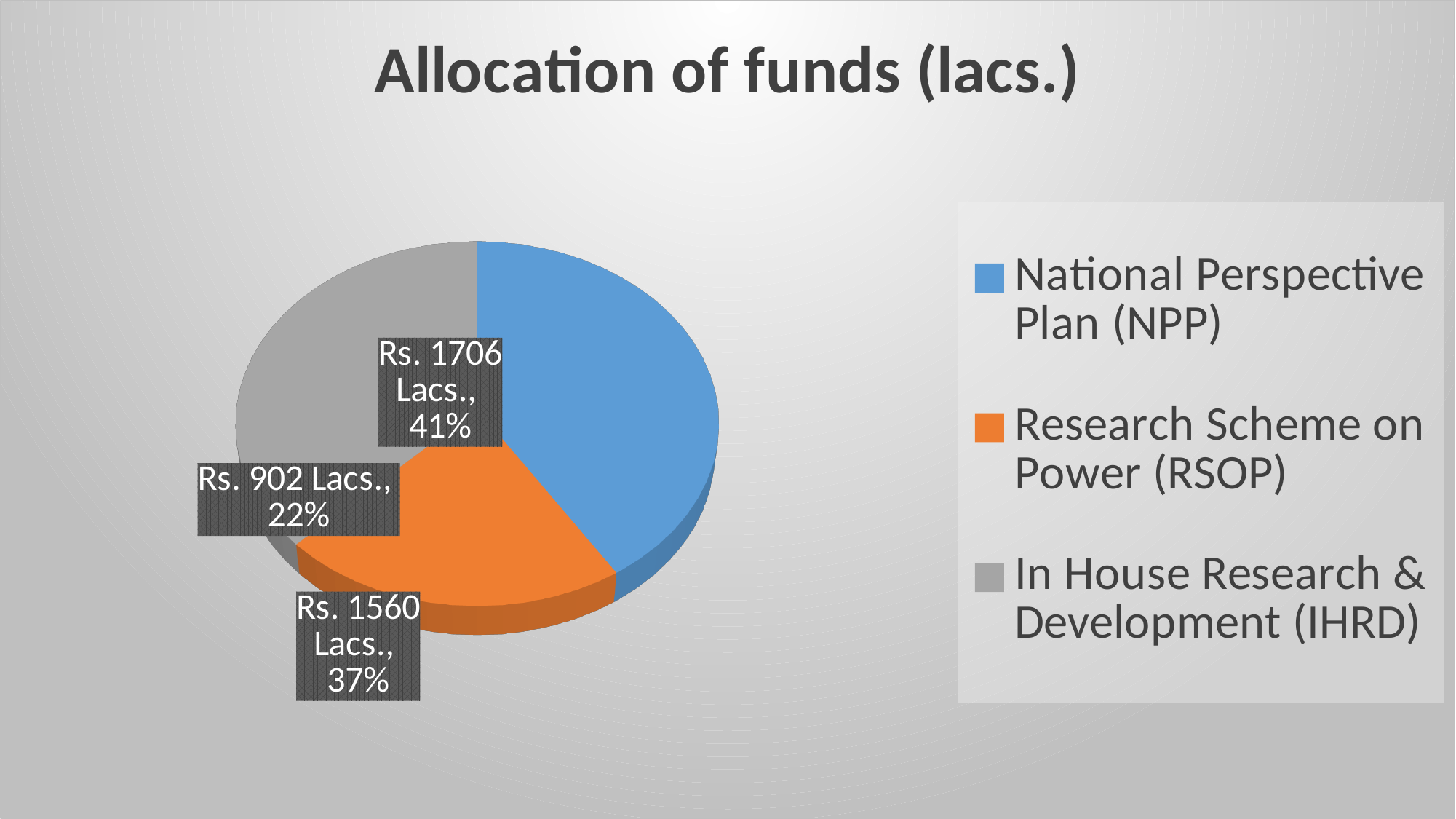
What is the title of the chart? Allocation of funds (lacs.) What percentage share is labelled for the slice worth Rs. 902 Lacs.? 22% What percentage share is labelled for the slice worth Rs. 1560 Lacs.? 37% What share of the pie is the 41% slice's value in rupees? Rs. 1706 Lacs. Which category has the largest slice of the pie? National Perspective Plan (NPP) What is the difference between the Rs. 1706 Lacs. slice and the Rs. 902 Lacs. slice? Rs. 804 Lacs. What colour represents In House Research & Development (IHRD) in the legend? grey What kind of chart is shown on the slide? pie chart How many categories does the legend list? 3 Which is larger, the slice labelled 41% or the slice labelled 37%? the slice labelled 41% How many slices does the pie chart have? 3 Which category has the smallest slice of the pie? Research Scheme on Power (RSOP)